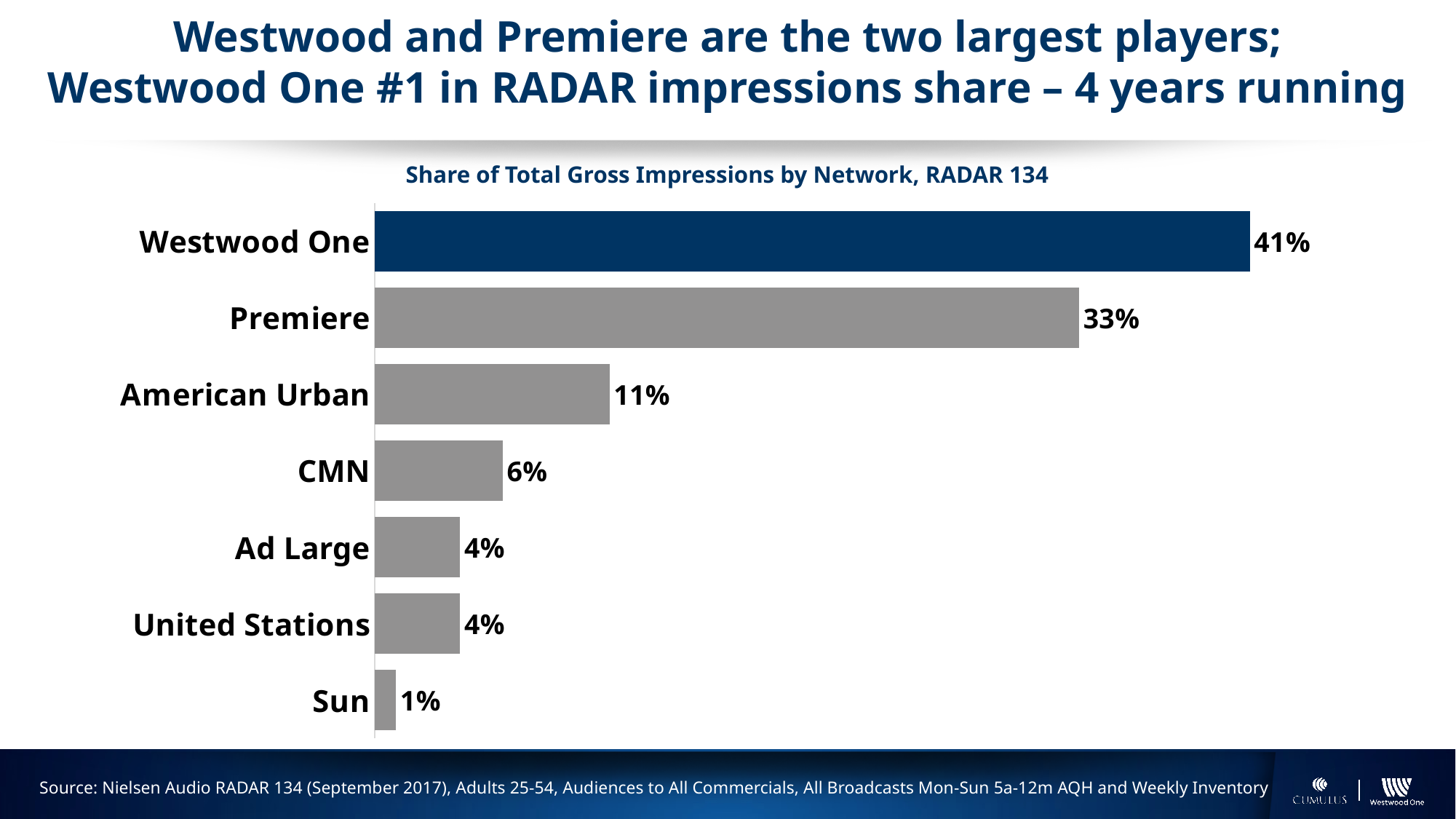
What is the share of total gross impressions for Westwood One? 41% What is the difference in share between Westwood One and Premiere? 8% How many networks are shown in the chart? 7 What is the difference in share between American Urban and CMN? 5% What is the share of total gross impressions for American Urban? 11% What is the title of the chart? Share of Total Gross Impressions by Network, RADAR 134 Which network has the lowest share of total gross impressions? Sun What is the share of total gross impressions for Premiere? 33% What is the share of total gross impressions for CMN? 6% What kind of chart is shown on the slide? Bar chart Which has a larger share, Premiere or American Urban? Premiere Which network has the highest share of total gross impressions? Westwood One